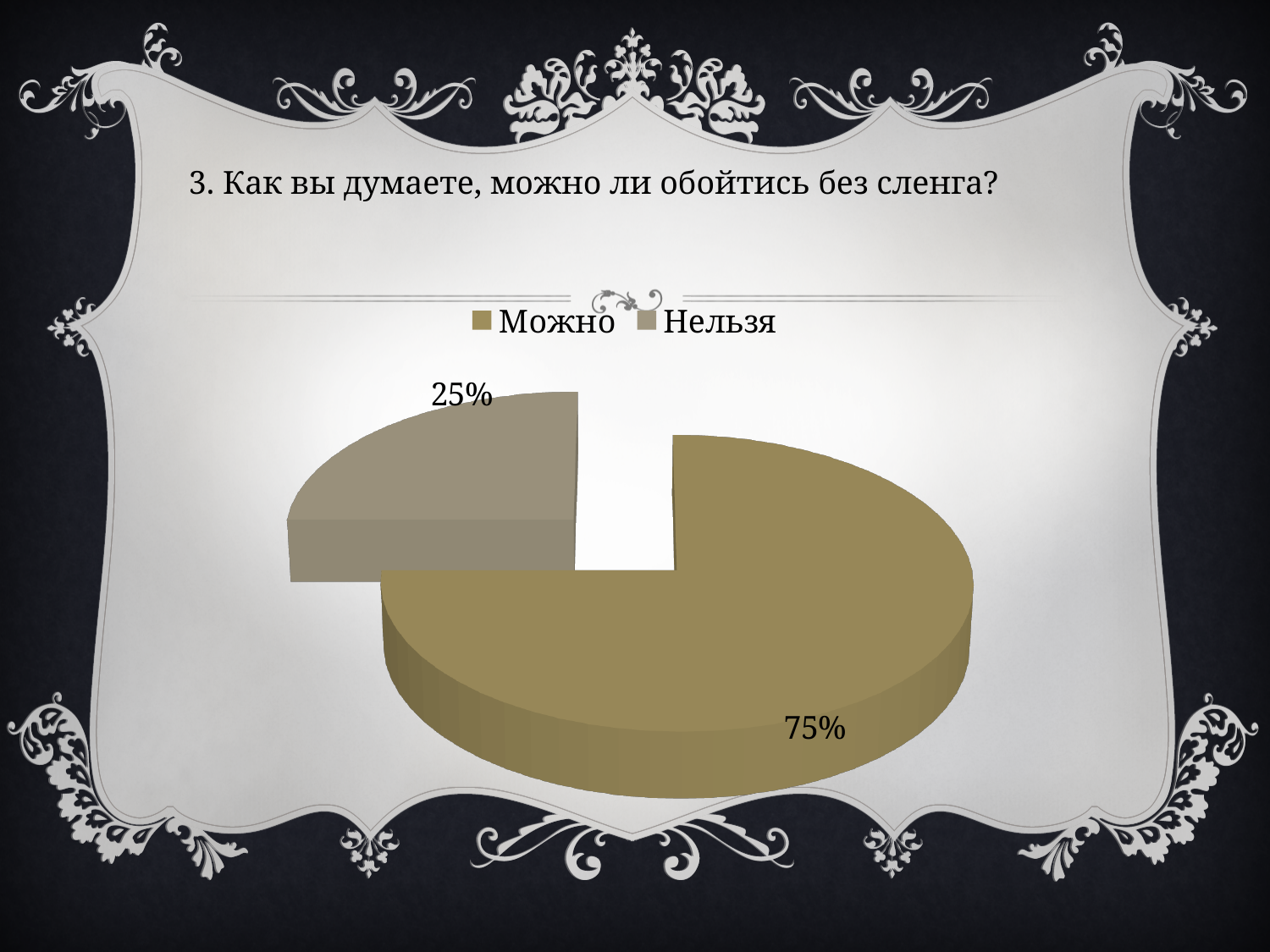
How many entries does the legend list? 2 What is the difference in percentage points between the "Можно" and "Нельзя" slices? 50% What question is shown as the title above the chart? 3. Как вы думаете, можно ли обойтись без сленга? What kind of chart is shown on the slide? pie chart Which category has the largest slice of the pie? Можно What share of the pie does "Можно" take? 75% How many slices does the pie chart have? 2 What share of the pie does "Нельзя" take? 25% Which category has the smallest slice of the pie? Нельзя Which is larger, the slice for "Можно" or the slice for "Нельзя"? Можно Which legend entry is listed first? Можно